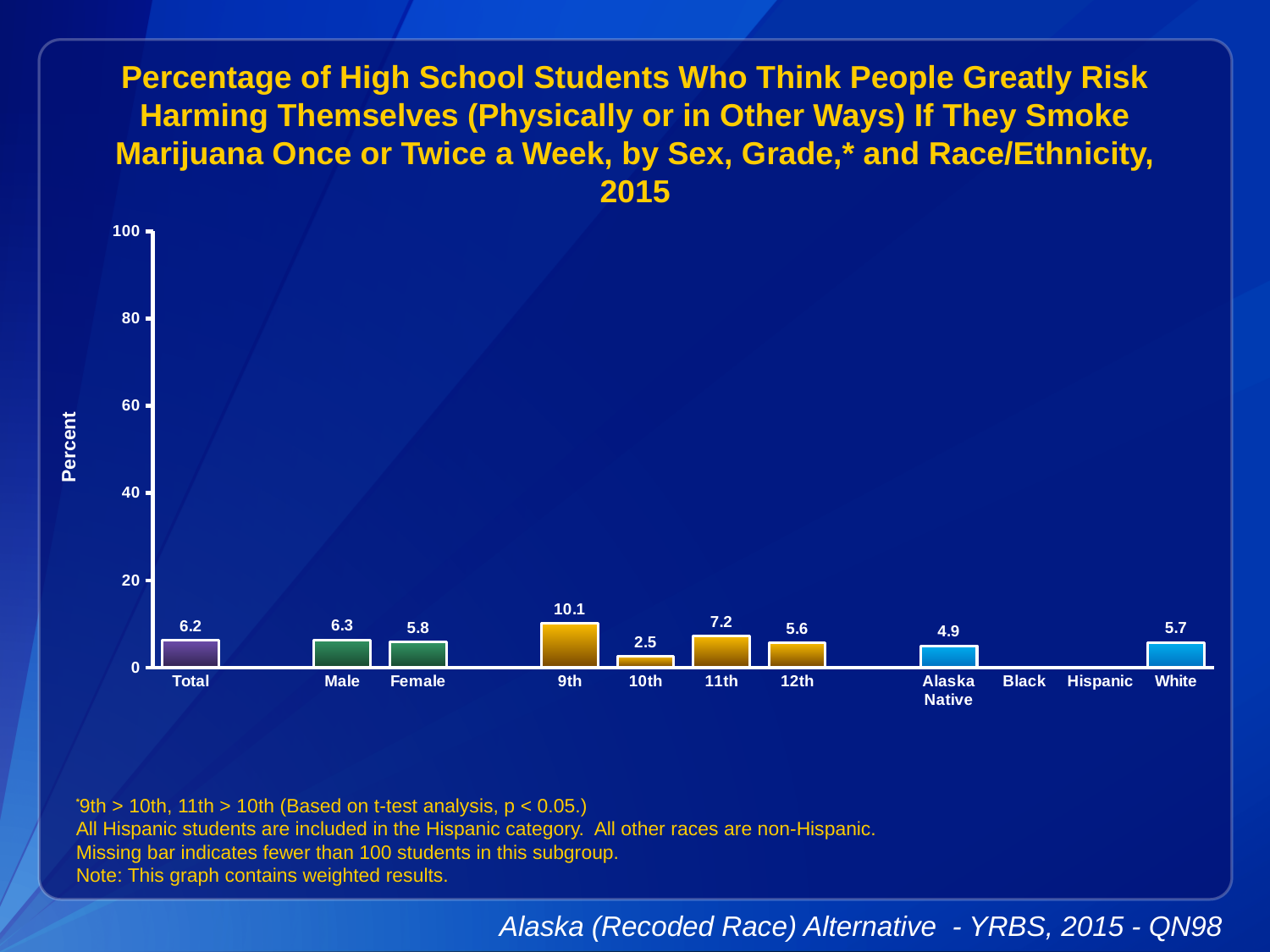
Which is larger, the value for 11th or the value for 12th? 11th Which category with a plotted bar has the lowest value? 10th What is the value for 10th grade? 2.5 How many categories are labeled on the x axis? 11 Which categories have no bar plotted? Black and Hispanic What is the value for Total? 6.2 What is the value for Alaska Native? 4.9 What is the difference between the values for 9th and 10th grade? 7.6 Is the value for 9th grade greater or less than 20? less Which category has the highest value? 9th What is the difference between the values for Male and Female? 0.5 What kind of chart is shown? bar chart